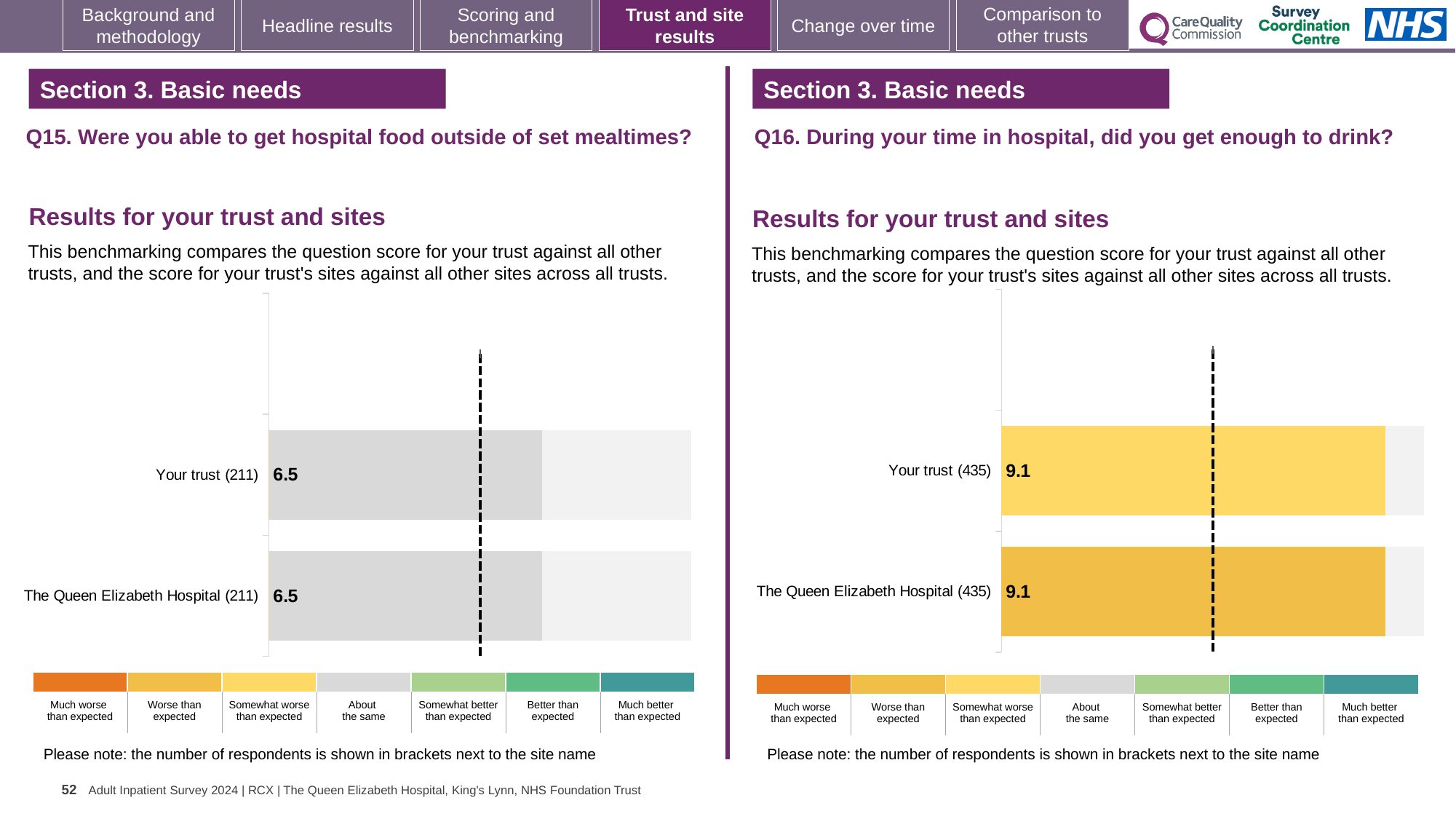
In the Q16 chart on the right, how many respondents are shown in brackets for The Queen Elizabeth Hospital? 435 In the Q16 chart on the right, what is the score for The Queen Elizabeth Hospital? 9.1 How many bars are plotted in the Q15 chart on the left? 2 In the Q15 chart on the left, what is the score for Your trust? 6.5 How many bars are plotted in the Q16 chart on the right? 2 What kind of chart is the Q16 chart on the right? Bar chart In the Q16 chart on the right, what is the score for Your trust? 9.1 In the Q15 chart on the left, what is the difference between the score for Your trust and the score for The Queen Elizabeth Hospital? 0 In the Q15 chart on the left, how many respondents are shown in brackets for Your trust? 211 In the Q16 chart on the right, what is the difference between the score for Your trust and the score for The Queen Elizabeth Hospital? 0 In the Q15 chart on the left, what is the score for The Queen Elizabeth Hospital? 6.5 In the Q16 chart on the right, is the score for Your trust greater or less than the score for The Queen Elizabeth Hospital, or are they equal? Equal